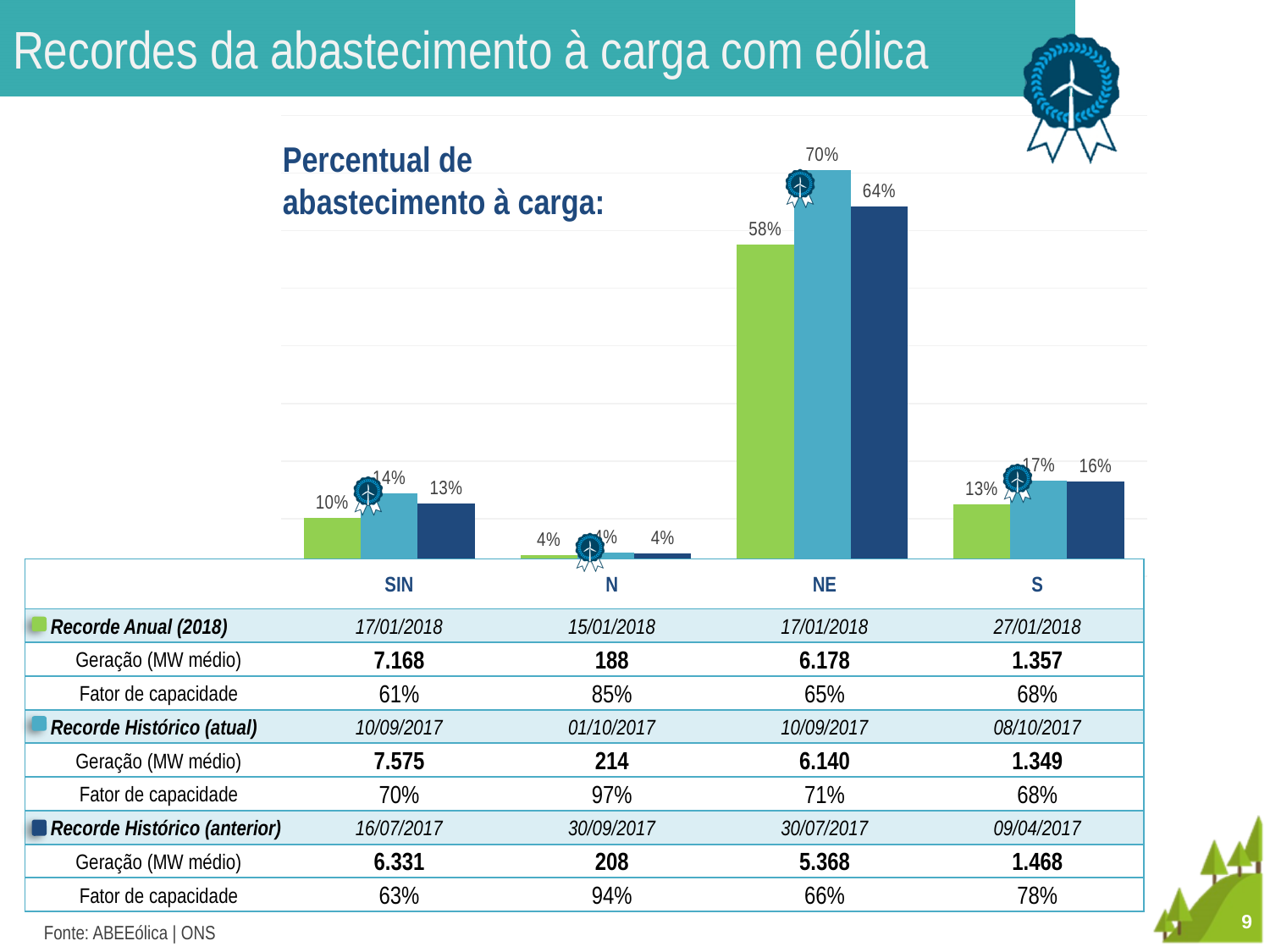
What kind of chart is shown on the slide? Bar chart Which region has the lowest Recorde Anual (2018) percentage? N What is the Recorde Histórico (atual) percentage for SIN? 14% What is the Recorde Histórico (anterior) percentage for S? 16% What is the difference between the Recorde Histórico (anterior) percentages for NE and SIN? 51% Which region has the highest Recorde Histórico (atual) percentage? NE How many regions are shown on the x axis of the chart? 4 What is the difference between the Recorde Histórico (atual) and Recorde Anual (2018) percentages for NE? 12% For S, which is larger: the Recorde Histórico (atual) or the Recorde Histórico (anterior) percentage? Recorde Histórico (atual) Which series is shown in green in the chart? Recorde Anual (2018) What is the Recorde Anual (2018) percentage of load supply for NE? 58% How many series does the chart show? 3